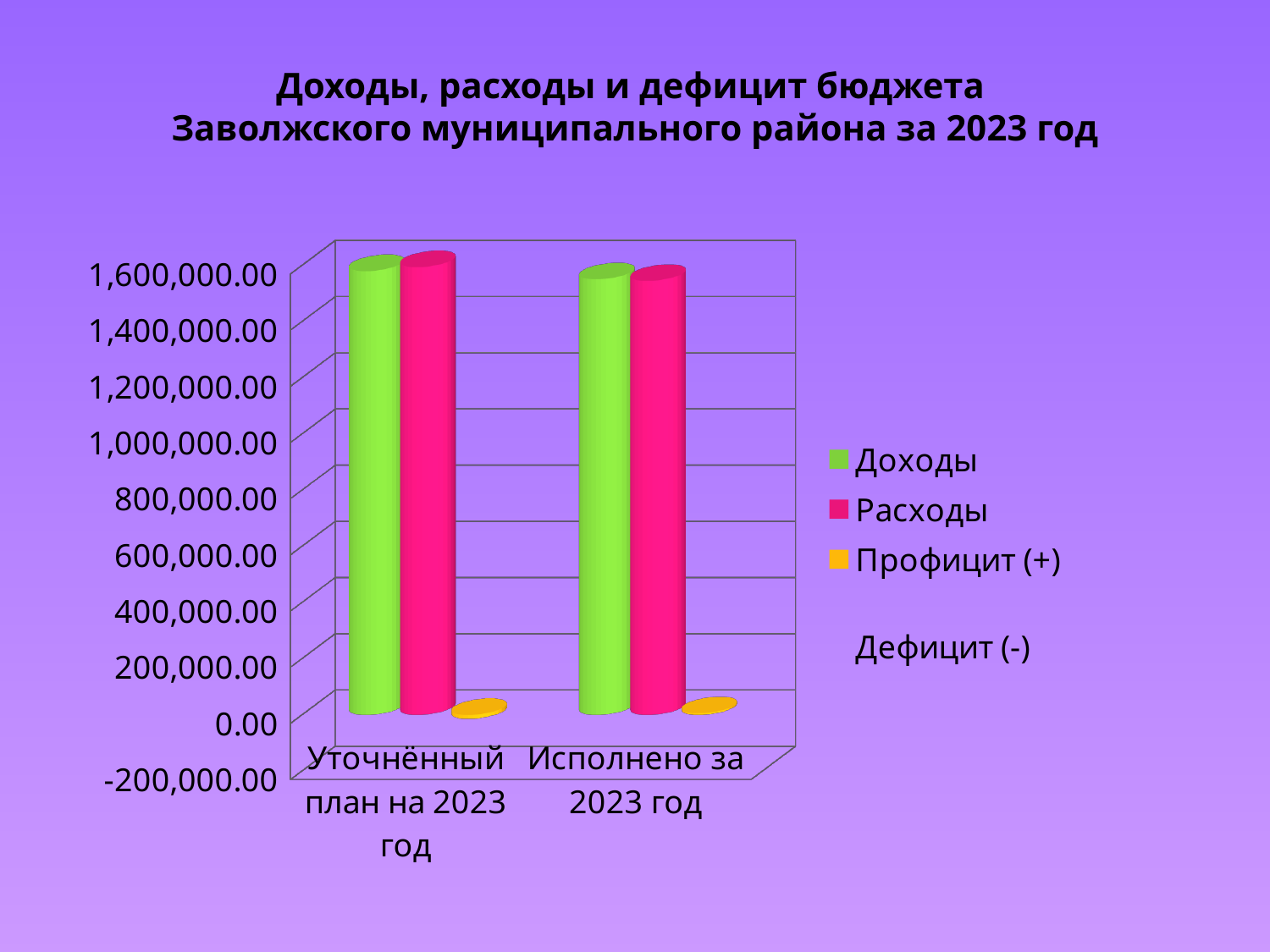
What kind of chart is shown on the slide? bar chart How many series does the legend list? 3 Which is larger: Расходы for Уточнённый план на 2023 год or Расходы for Исполнено за 2023 год? Уточнённый план на 2023 год Is the value of Расходы for Исполнено за 2023 год greater or less than 1,200,000.00? greater Is the value of Доходы for Исполнено за 2023 год greater or less than 1,000,000.00? greater Is the value of Профицит (+) Дефицит (-) for Исполнено за 2023 год greater or less than 200,000.00? less Which series has the lowest value for Уточнённый план на 2023 год? Профицит (+) Дефицит (-) What is the title of the chart? Доходы, расходы и дефицит бюджета Заволжского муниципального района за 2023 год Which series is shown in green in the legend? Доходы What is the highest value shown on the vertical axis? 1,600,000.00 How many categories are shown on the x axis? 2